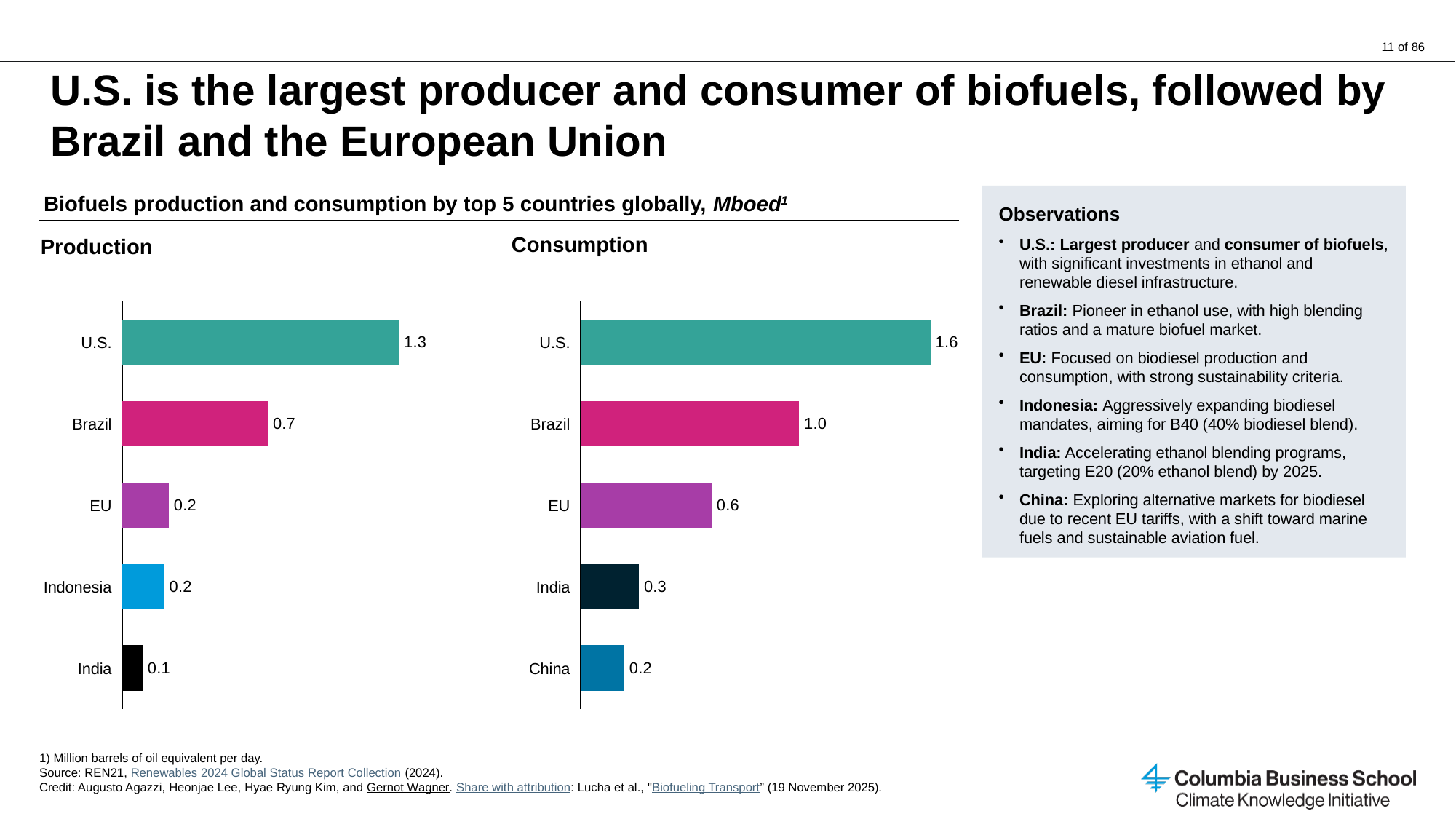
How many countries are shown in the Consumption chart? 5 In the Consumption chart, what is the value for the EU? 0.6 What type of chart is the Production chart? Bar chart In the Consumption chart, what is the difference between the U.S. and Brazil values? 0.6 In the Production chart, what is the difference between the U.S. and Brazil values? 0.6 Which country appears in the Consumption chart but not in the Production chart? China In the Consumption chart, which country has the highest value? U.S. In the Production chart, what is the value for the U.S.? 1.3 Which is larger: Brazil's production or Brazil's consumption? Brazil's consumption In the Production chart, which country has the lowest value? India In the Consumption chart, what is the value for Brazil? 1.0 In the Production chart, what is the value for India? 0.1